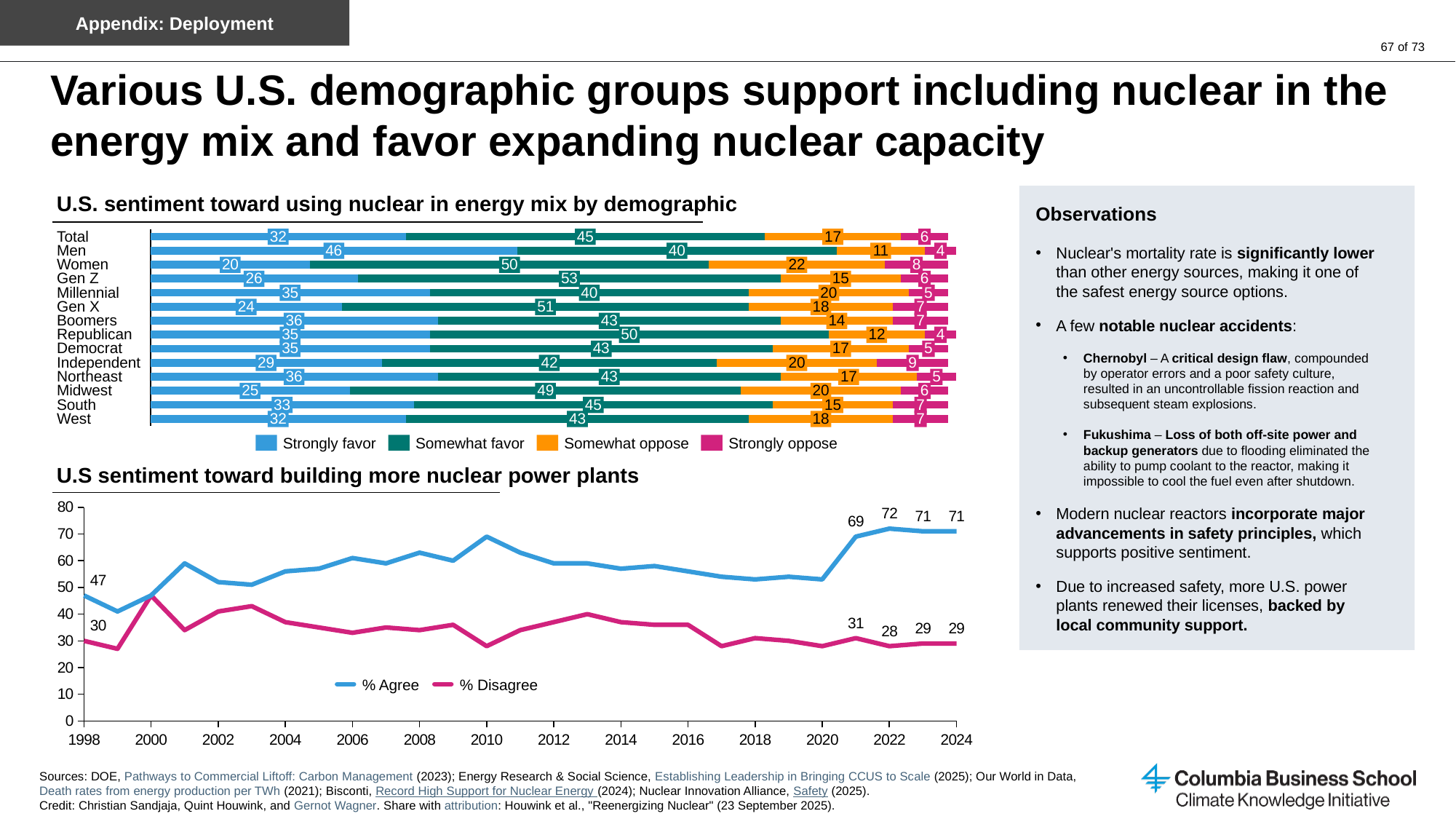
In the chart 'U.S sentiment toward building more nuclear power plants', what kind of chart is used? Line chart In the chart 'U.S. sentiment toward using nuclear in energy mix by demographic', how many series does the legend list? 4 In the chart 'U.S. sentiment toward using nuclear in energy mix by demographic', what is the difference between the Somewhat oppose values for Women and Men? 11 In the chart 'U.S. sentiment toward using nuclear in energy mix by demographic', which demographic group has the lowest Strongly favor value? Women In the chart 'U.S sentiment toward building more nuclear power plants', what is the difference between % Agree and % Disagree in 2024? 42 In the chart 'U.S sentiment toward building more nuclear power plants', what is the % Agree value in 2022? 72 In the chart 'U.S. sentiment toward using nuclear in energy mix by demographic', what is the total of the four segments for the Total bar? 100 In the chart 'U.S. sentiment toward using nuclear in energy mix by demographic', which has the larger Somewhat favor value, Gen Z or Millennial? Gen Z In the chart 'U.S. sentiment toward using nuclear in energy mix by demographic', which demographic group has the highest Strongly favor value? Men In the chart 'U.S. sentiment toward using nuclear in energy mix by demographic', what kind of chart is used? Bar chart In the chart 'U.S. sentiment toward using nuclear in energy mix by demographic', what is the Strongly favor value for Men? 46 In the chart 'U.S. sentiment toward using nuclear in energy mix by demographic', how many demographic groups are shown? 14